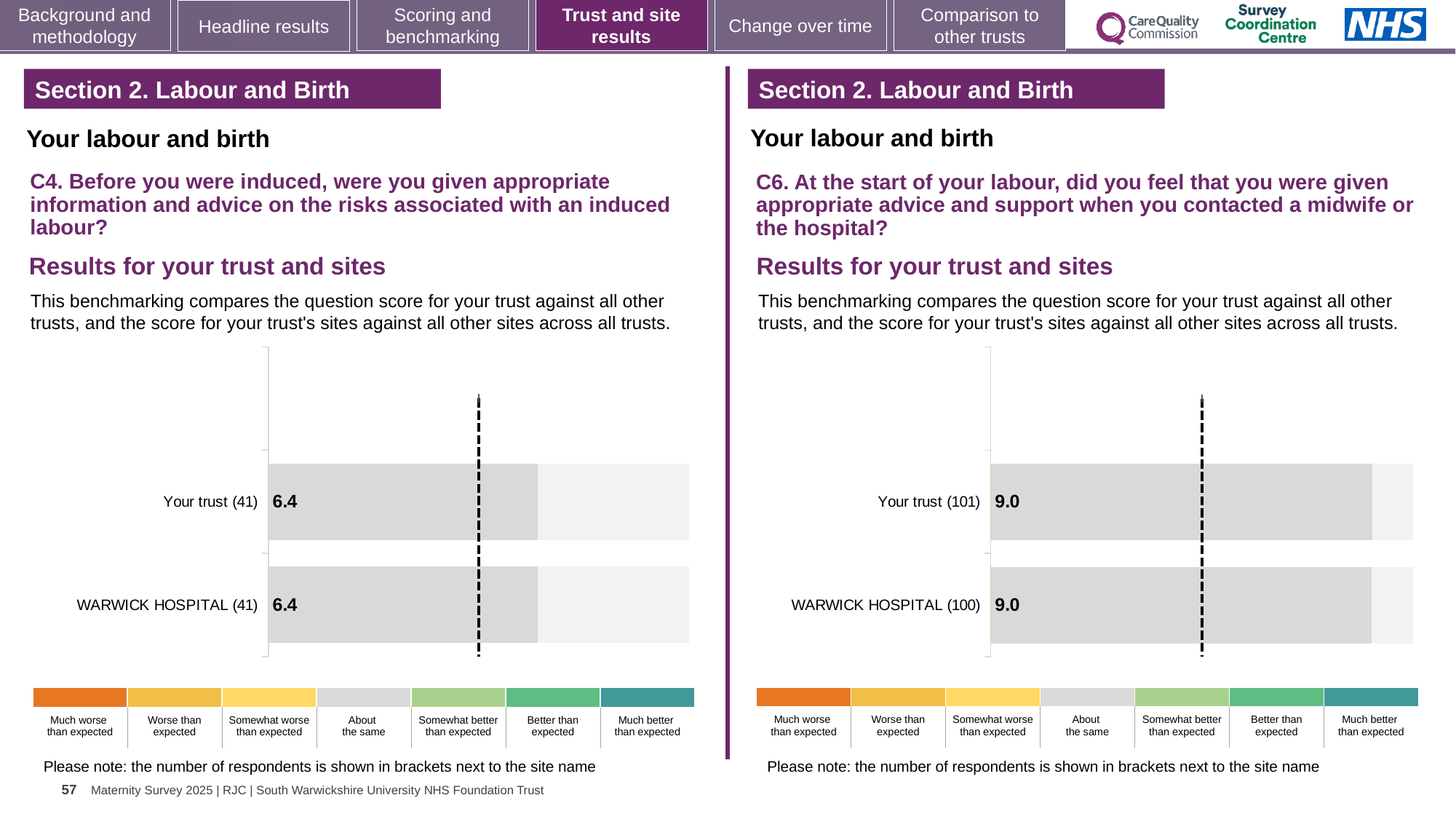
In the left chart (C4), how many respondents are shown in brackets for Your trust? 41 In the left chart (C4), what is the difference between the score for Your trust and the score for WARWICK HOSPITAL? 0.0 In the right chart (C6), how many respondents are shown in brackets for WARWICK HOSPITAL? 100 In the right chart (C6), how many respondents are shown in brackets for Your trust? 101 How many bars are plotted in the left chart (C4)? 2 In the left chart (C4), what is the score for WARWICK HOSPITAL? 6.4 In the right chart (C6), what is the score for Your trust? 9.0 How many bars are plotted in the right chart (C6)? 2 What kind of chart is used in the left chart (C4)? Bar chart In the right chart (C6), what is the score for WARWICK HOSPITAL? 9.0 In the right chart (C6), what is the difference between the score for Your trust and the score for WARWICK HOSPITAL? 0.0 In the left chart (C4), what is the score for Your trust? 6.4